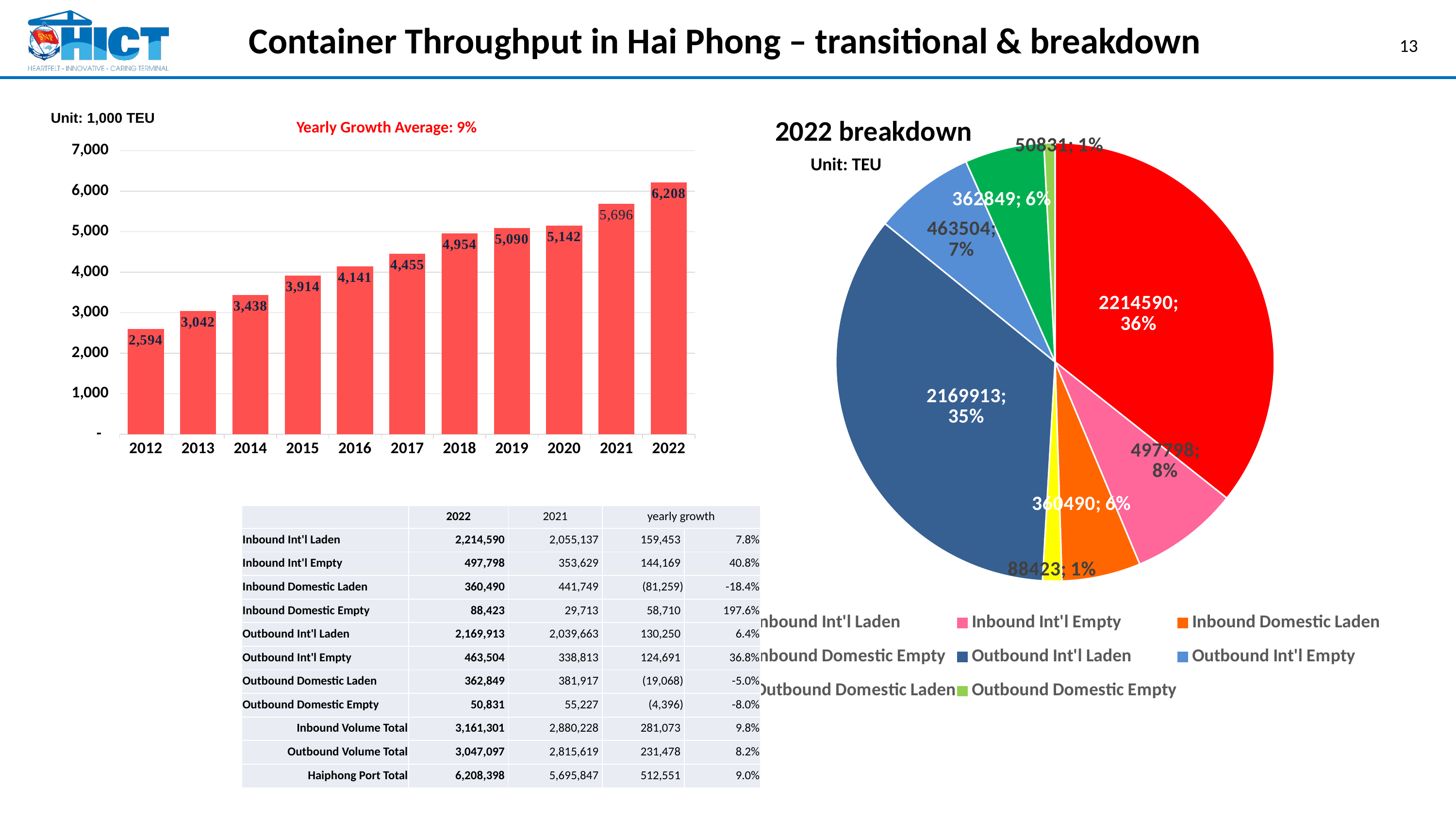
On the left bar chart, which year has the highest throughput? 2022 What is the unit stated for the left bar chart? 1,000 TEU In the 2022 breakdown pie chart, what share does Inbound Int'l Laden have? 36% In the 2022 breakdown pie chart, what is the value for Outbound Int'l Laden? 2169913 On the left bar chart, how many years are shown? 11 In the 2022 breakdown pie chart, which is larger: Inbound Int'l Empty or Outbound Domestic Laden? Inbound Int'l Empty What type of chart is the left chart showing throughput by year? bar chart On the left bar chart, do the values rise or fall from 2012 to 2022? rise On the left bar chart, which year has the lowest throughput? 2012 On the left bar chart, what is the difference between the 2022 and 2021 values? 512 On the left bar chart, what was the container throughput in 2012? 2,594 On the left bar chart, what was the container throughput in 2022? 6,208